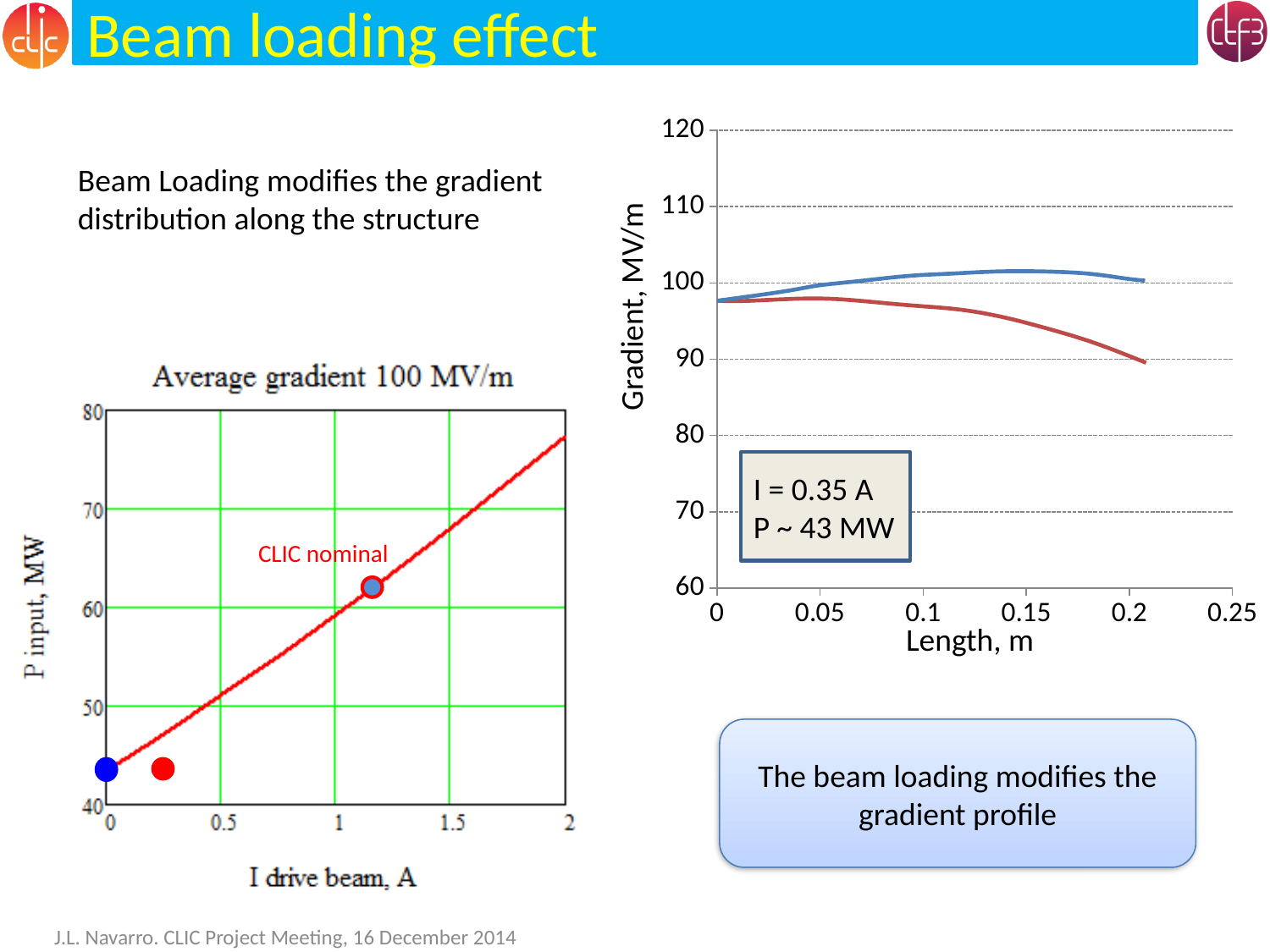
What kind of chart is the chart on the left titled 'Average gradient 100 MV/m'? line chart What kind of chart is the chart on the right of the slide (Gradient vs Length)? line chart On the right chart, how many curves are plotted? 2 On the right chart, what is the label of the y axis? Gradient, MV/m On the right chart, does the red curve overall rise or fall as length increases from 0 to about 0.2 m? fall On the right chart, is the value of the red curve at a length of 0.2 m greater or less than 100? less On the right chart, at a length of 0.2 m, which curve has the higher gradient, the blue or the red? blue What is the title of the chart on the left of the slide? Average gradient 100 MV/m On the right chart, is the value of the blue curve at a length of 0.15 m greater or less than 100? greater On the left chart, does P input rise or fall as I drive beam increases? rise On the left chart, is the P input value of the red line at I drive beam = 0 A greater or less than 50 MW? less